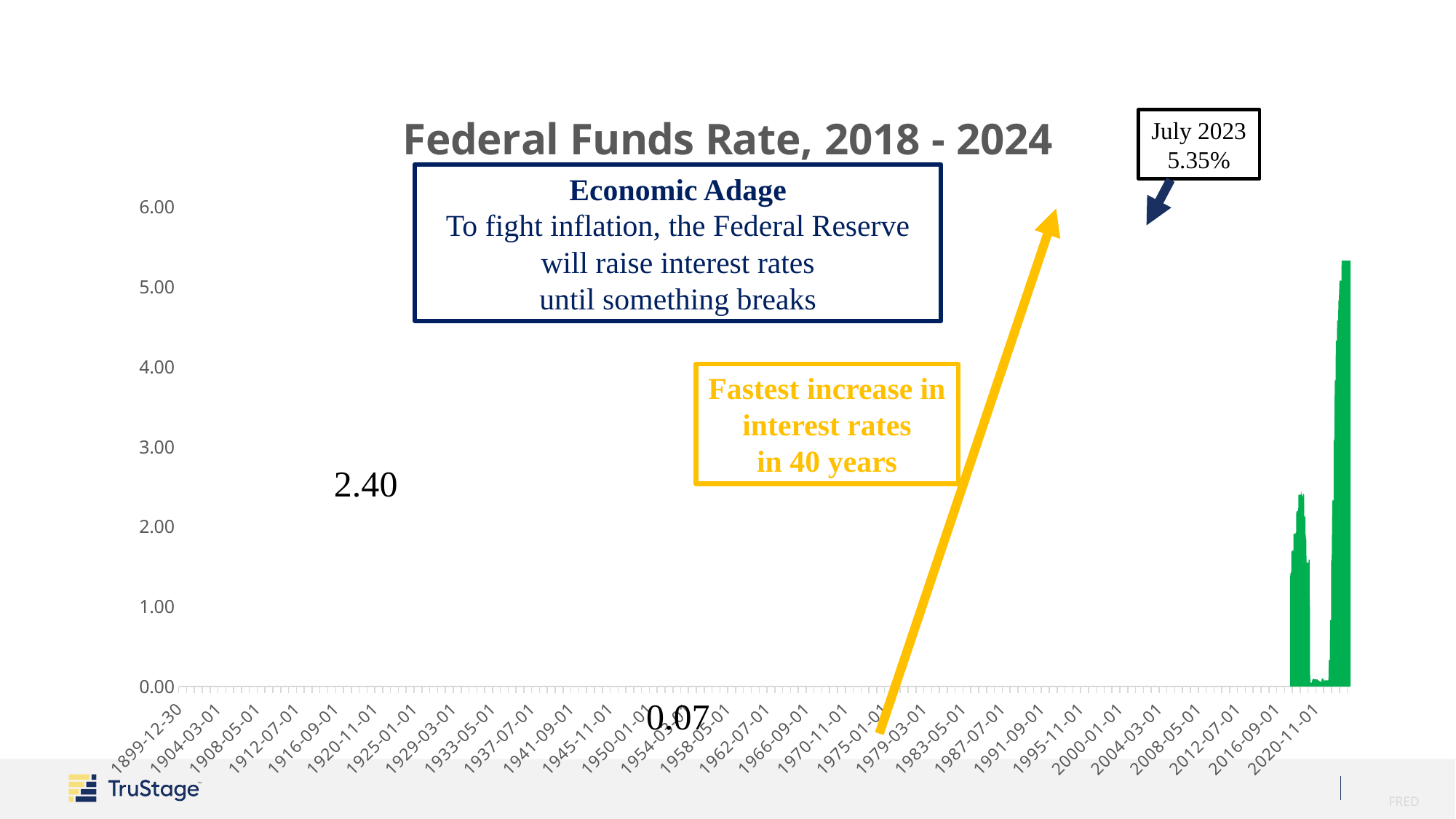
What value does the callout give for the Federal Funds Rate in July 2023? 5.35% What is the title of the chart? Federal Funds Rate, 2018 - 2024 Is the peak value of the Federal Funds Rate shown on the chart greater or less than 5.00? greater Does the Federal Funds Rate rise or fall over the final portion of the chart leading up to July 2023? rise What is the earliest date label shown on the x-axis? 1899-12-30 Is the first (earlier) peak of the green series greater or less than 2.00? greater What colour is the plotted data series? green What value is printed in the annotation near the bottom of the chart, below the x-axis? 0.07 Is the first (earlier) peak of the green series greater or less than 3.00? less What value is printed in the annotation on the left side of the plot area, near the 2.00 and 3.00 gridlines? 2.40 What is the highest value shown on the y-axis? 6.00 Which of the two peaks of the green series is higher, the earlier one or the later one? the later one